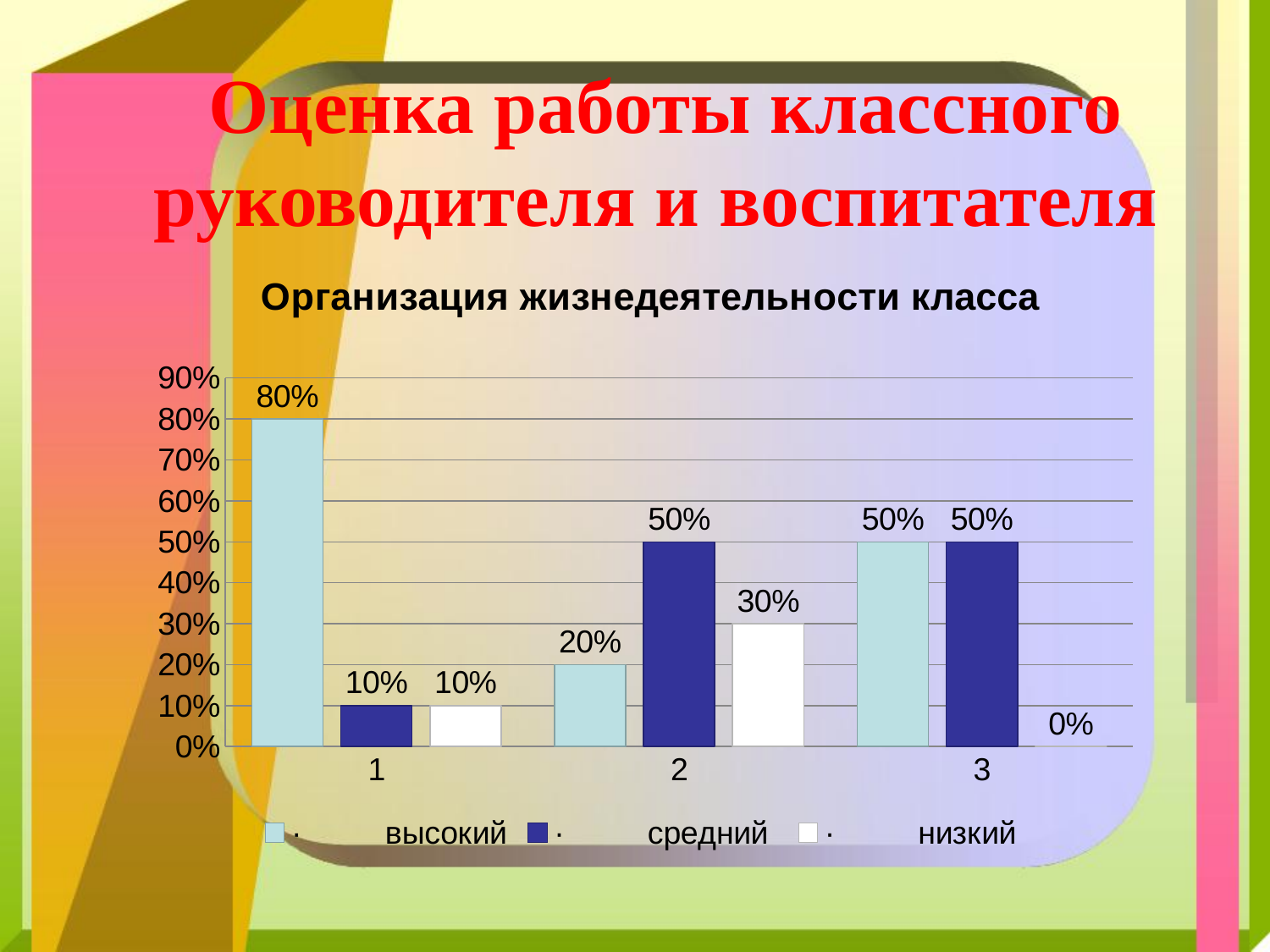
In which category is the "высокий" series highest? 1 What kind of chart is shown on the slide? bar chart What is the value for "высокий" in category 1? 80% What is the value for "средний" in category 3? 50% How many series does the legend list? 3 What is the value for "низкий" in category 3? 0% In which category is the "низкий" series lowest? 3 What is the difference between "высокий" and "средний" in category 1? 70% What is the value for "низкий" in category 2? 30% How many categories are shown on the x axis? 3 What is the title of the chart? Организация жизнедеятельности класса Which is larger in category 2: "средний" or "низкий"? средний